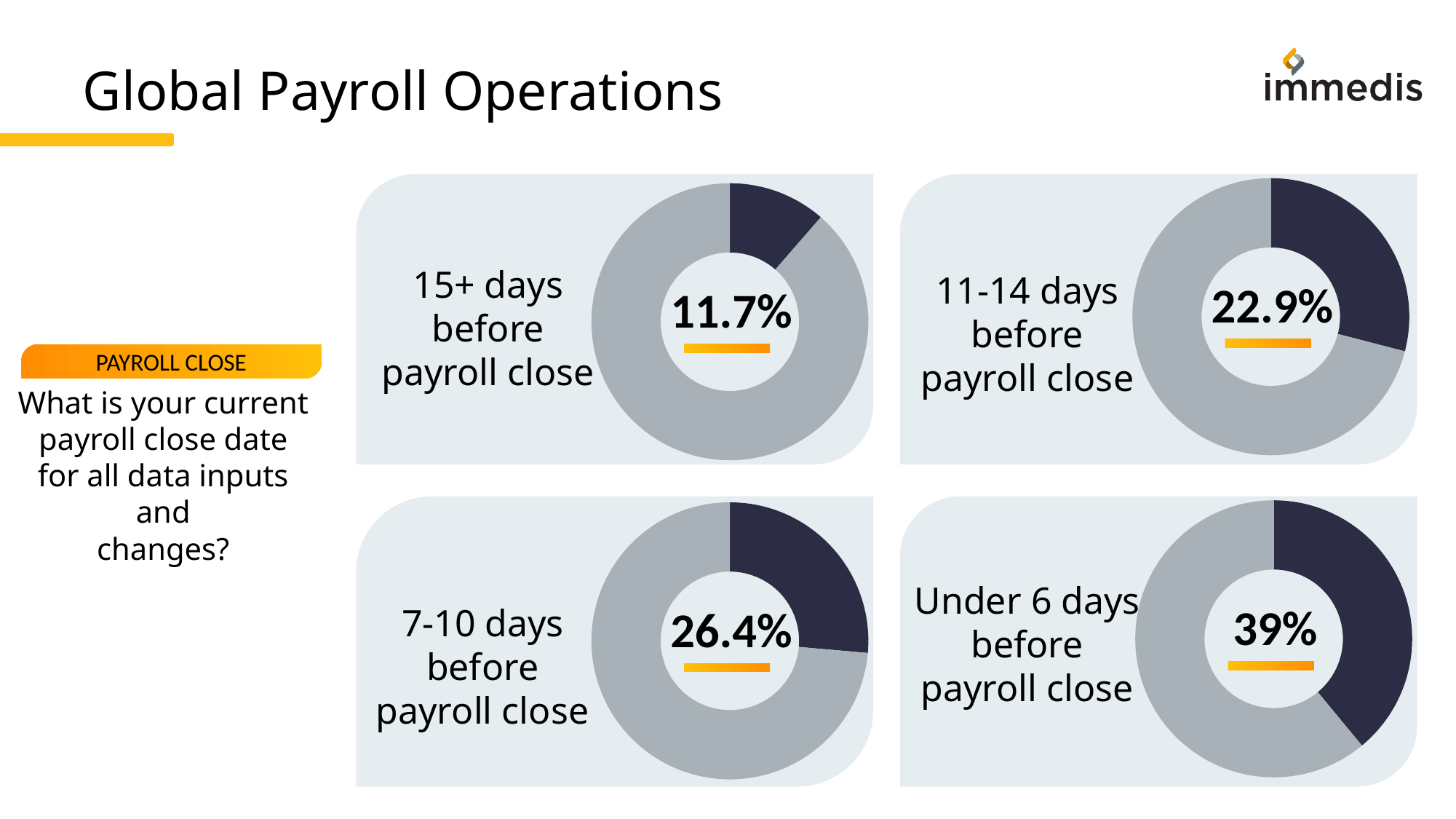
What percentage is shown in the donut chart labelled '7-10 days before payroll close'? 26.4% What kind of chart is used to display each percentage on the slide? Donut chart How many donut charts are shown on the slide? 4 What percentage is shown in the donut chart labelled '15+ days before payroll close'? 11.7% What percentage is shown in the donut chart labelled '11-14 days before payroll close'? 22.9% Across the four donut charts, which payroll close timing has the lowest percentage? 15+ days before payroll close What is the difference between the percentage in the 'Under 6 days before payroll close' chart and the percentage in the '15+ days before payroll close' chart? 27.3% What survey question do the four donut charts answer, according to the text on the left of the slide? What is your current payroll close date for all data inputs and changes? Which is larger: the percentage in the '7-10 days before payroll close' chart or the percentage in the '11-14 days before payroll close' chart? 7-10 days before payroll close What percentage is shown in the donut chart labelled 'Under 6 days before payroll close'? 39% Across the four donut charts, which payroll close timing has the highest percentage? Under 6 days before payroll close